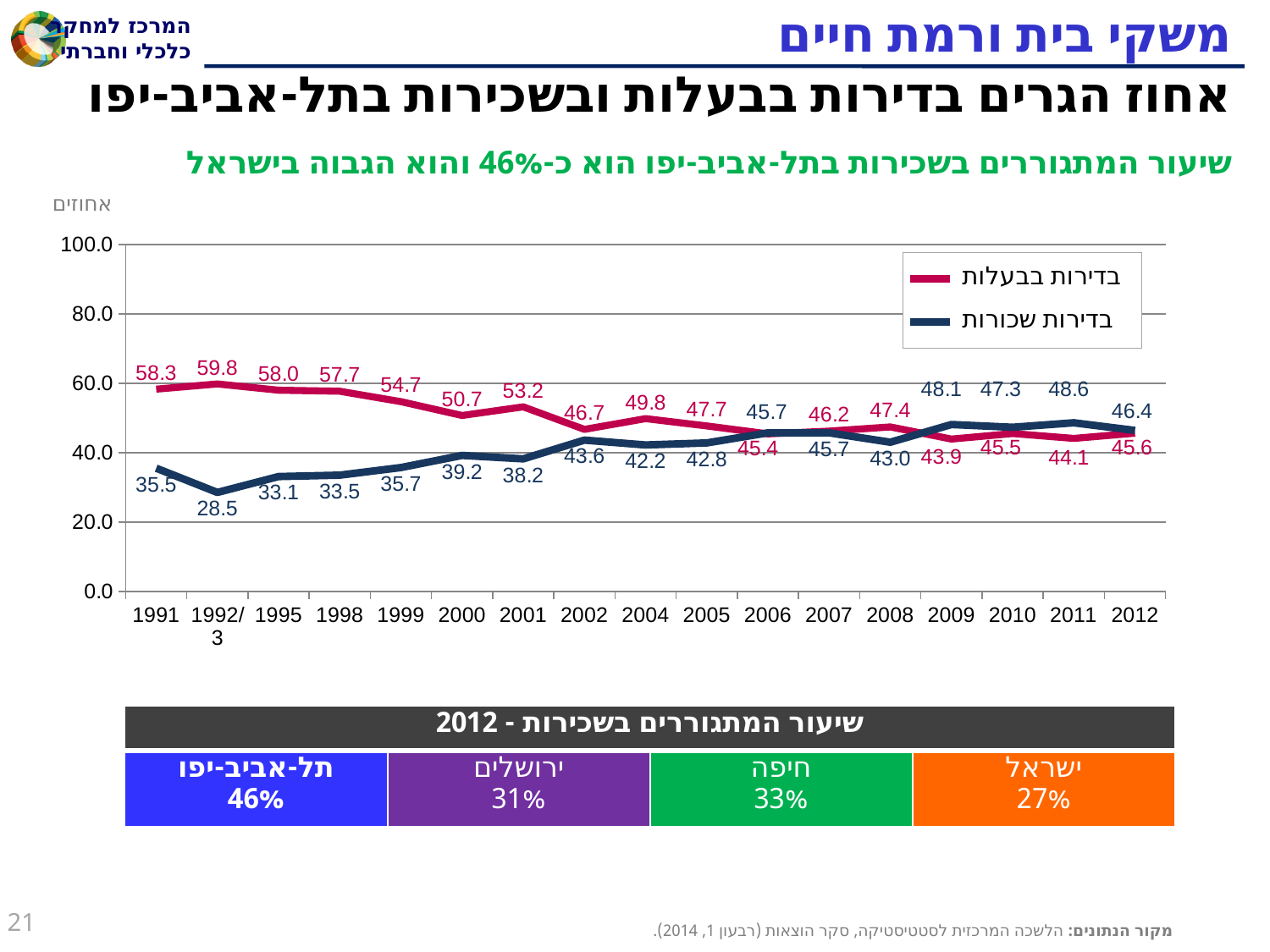
What is the value for בדירות שכורות in 1991? 35.5 What is the value for בדירות שכורות in 2012? 46.4 Is the value for בדירות שכורות in 2000 greater or less than 40.0? less How many series does the chart legend list? 2 Which series has the larger value in 2012, בדירות בבעלות or בדירות שכורות? בדירות שכורות What is the difference between בדירות בבעלות and בדירות שכורות in 1991? 22.8 What is the value for בדירות בבעלות in 1991? 58.3 What type of chart is shown on the slide? line chart In which year is the value for בדירות שכורות lowest? 1992/3 Does the value for בדירות בבעלות generally rise or fall from 1991 to 2012? fall In which year is the value for בדירות בבעלות highest? 1992/3 How many years (points) are plotted along the x axis of the chart? 17